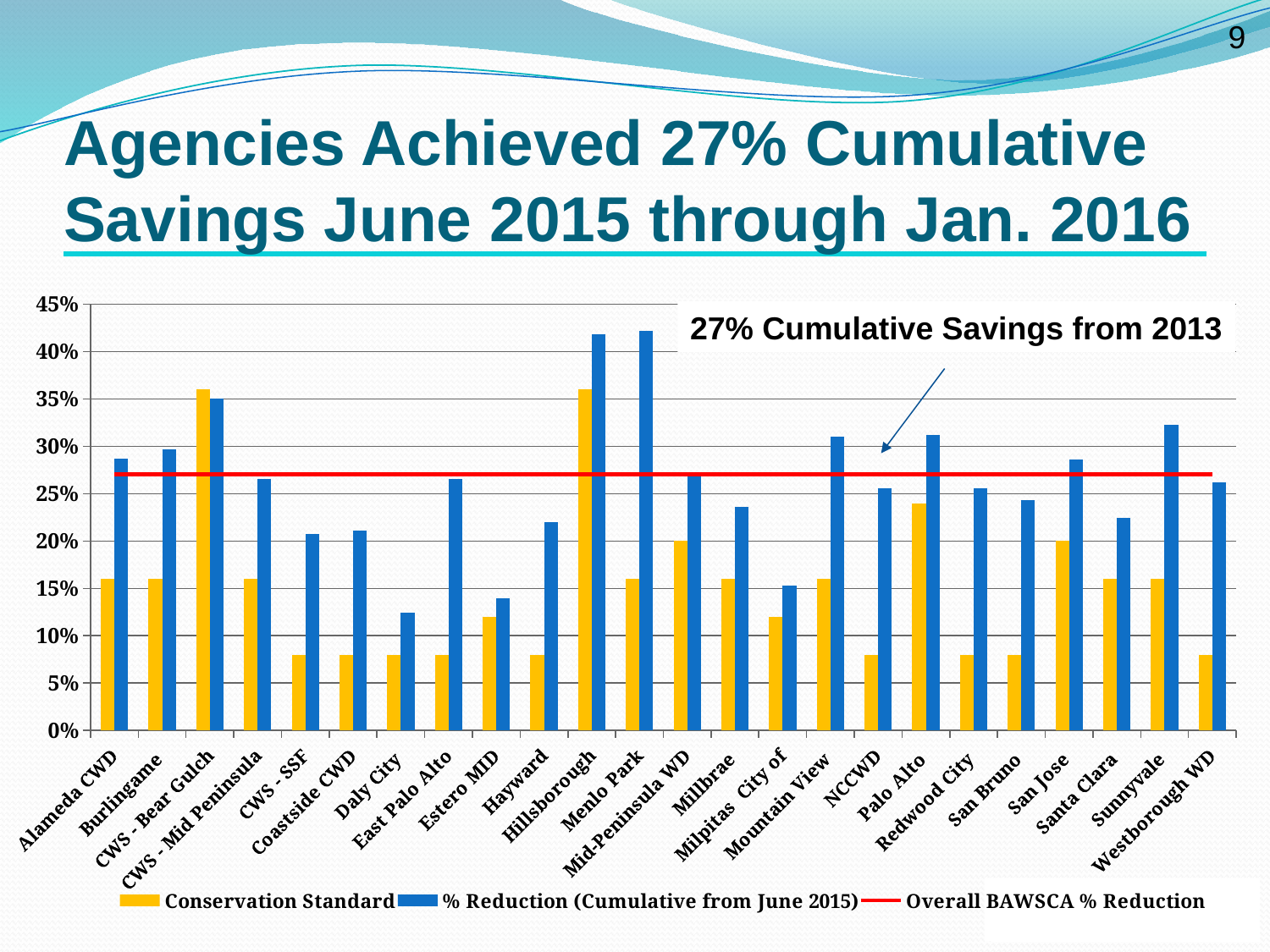
Is the % Reduction (Cumulative from June 2015) for Sunnyvale greater or less than 30%? greater Which agency has the lowest % Reduction (Cumulative from June 2015)? Daly City What kind of chart is shown on the slide? Combination bar and line chart Is the % Reduction (Cumulative from June 2015) for Milpitas City of greater or less than 20%? less Is the % Reduction (Cumulative from June 2015) for Hillsborough greater or less than 40%? greater What colour are the Conservation Standard bars in the chart? Yellow Which has the larger % Reduction (Cumulative from June 2015), Sunnyvale or Santa Clara? Sunnyvale Which has the larger Conservation Standard, CWS - Bear Gulch or Alameda CWD? CWS - Bear Gulch How many agencies (categories) are shown on the x axis of the chart? 24 How many series does the chart's legend list? 3 What is the Overall BAWSCA % Reduction shown by the red line on the chart? 27%